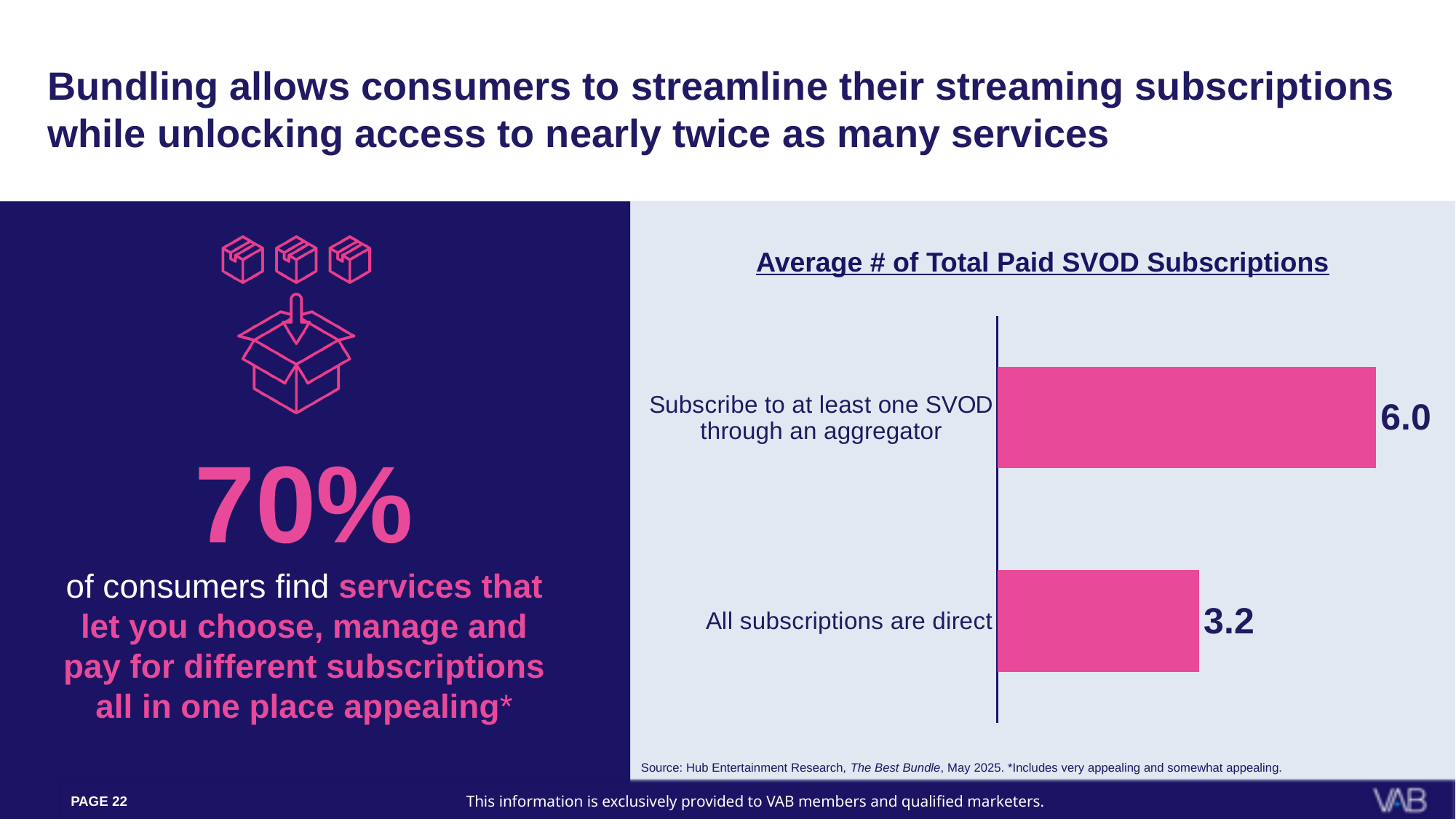
What colour are the bars in the chart? Pink What is the title of the chart? Average # of Total Paid SVOD Subscriptions Which category has the lower average number of total paid SVOD subscriptions? All subscriptions are direct Which category has the higher average number of total paid SVOD subscriptions? Subscribe to at least one SVOD through an aggregator What is the average number of total paid SVOD subscriptions for those who subscribe to at least one SVOD through an aggregator? 6.0 Is the average number of subscriptions larger for aggregator subscribers or for those with all direct subscriptions? Aggregator subscribers How many categories are shown in the chart? 2 What is the difference between the average number of paid SVOD subscriptions for aggregator subscribers and for those with all direct subscriptions? 2.8 What is the average number of total paid SVOD subscriptions for those whose subscriptions are all direct? 3.2 What kind of chart is shown on the slide? Bar chart